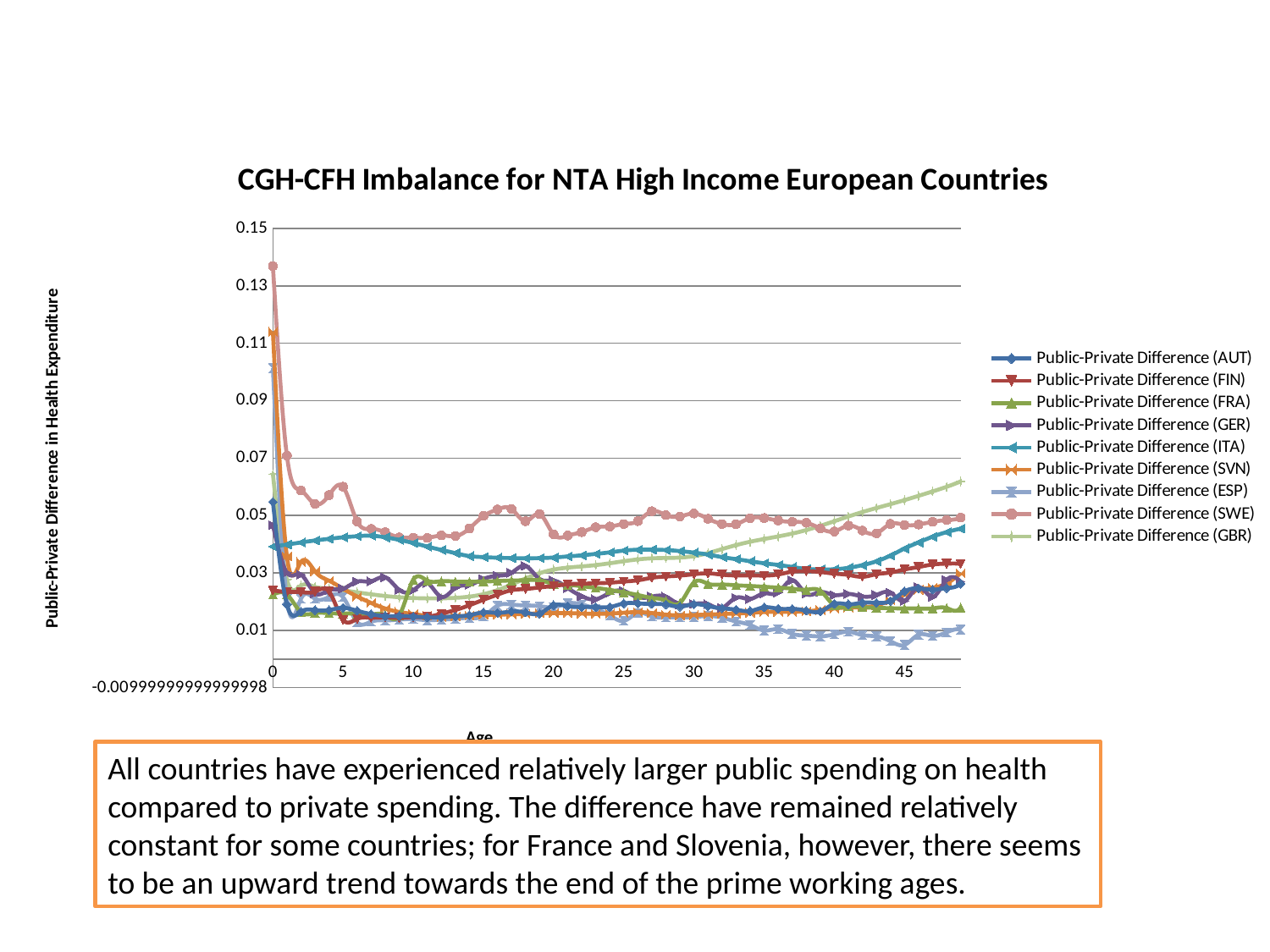
At age 40, which is larger: Public-Private Difference (SWE) or Public-Private Difference (ESP)? Public-Private Difference (SWE) What is the label of the vertical axis? Public-Private Difference in Health Expenditure What is the title of the chart? CGH-CFH Imbalance for NTA High Income European Countries Is the value for Public-Private Difference (SWE) at age 0 greater or less than 0.13? greater Which series has the highest value at age 0? Public-Private Difference (SWE) How many series does the legend list? 9 Does the Public-Private Difference (GBR) series rise or fall between age 30 and age 49? rise Which series has the highest value at the right end of the chart (age 49)? Public-Private Difference (GBR) Is the value for Public-Private Difference (GBR) at age 49 greater or less than 0.05? greater Which series has the lowest value at age 45? Public-Private Difference (ESP) Is the value for Public-Private Difference (ESP) at age 45 greater or less than 0.01? less What kind of chart is shown on the slide? Line chart